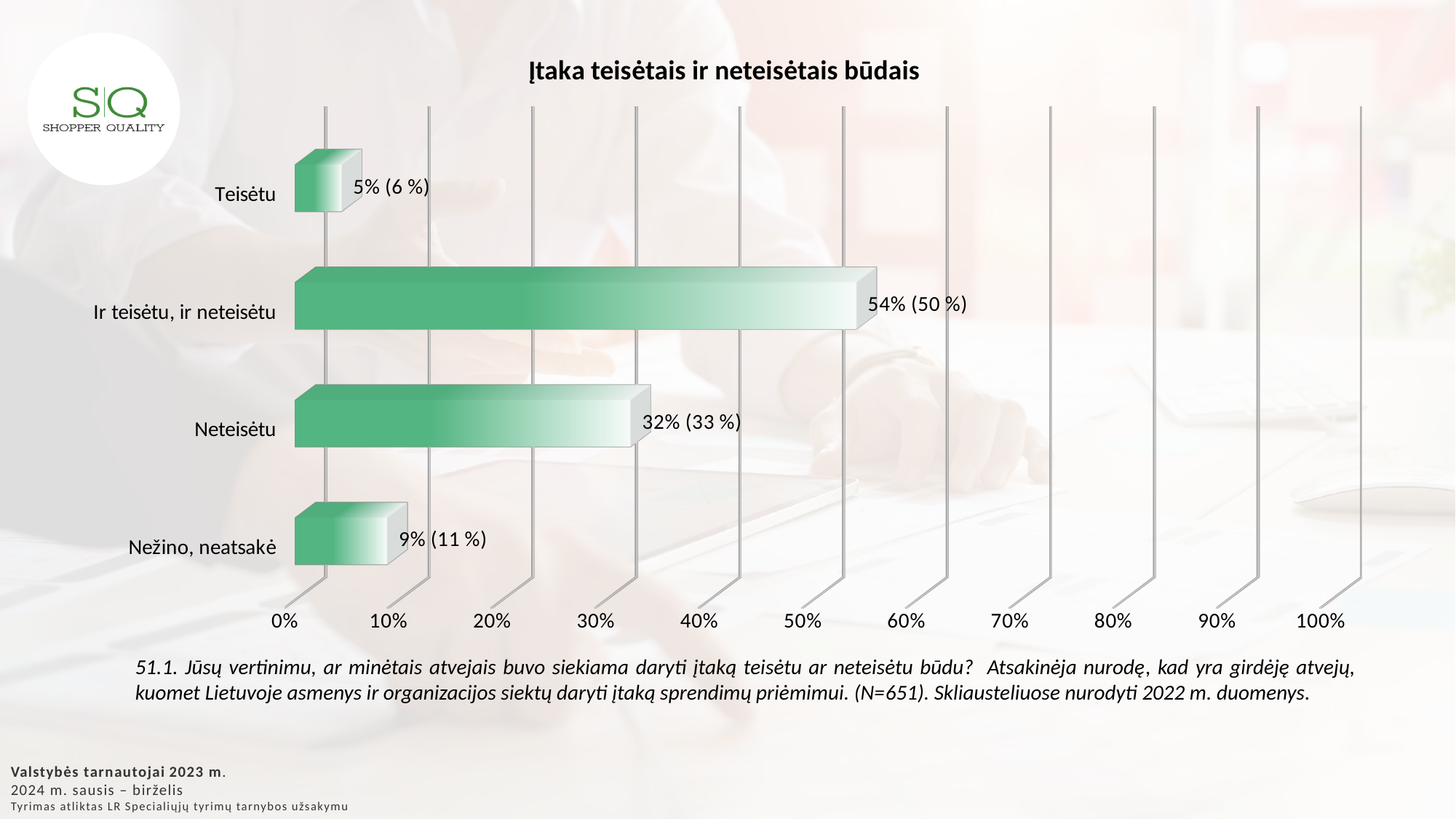
What is the 2022 value shown in parentheses for "Teisėtu"? 6 % What is the 2023 value for "Neteisėtu"? 32% Which category has the highest 2023 value? Ir teisėtu, ir neteisėtu Which category has the lowest 2023 value? Teisėtu Is the value for "Ir teisėtu, ir neteisėtu" greater or less than 50%? greater What is the 2022 value shown in parentheses for "Nežino, neatsakė"? 11 % Which is larger, the 2023 value for "Nežino, neatsakė" or for "Teisėtu"? Nežino, neatsakė How many categories are shown in the chart? 4 What kind of chart is shown on the slide? Bar chart What is the difference between the 2023 values for "Ir teisėtu, ir neteisėtu" and "Neteisėtu"? 22 percentage points What is the 2023 value for "Ir teisėtu, ir neteisėtu"? 54% What is the title of the chart? Įtaka teisėtais ir neteisėtais būdais